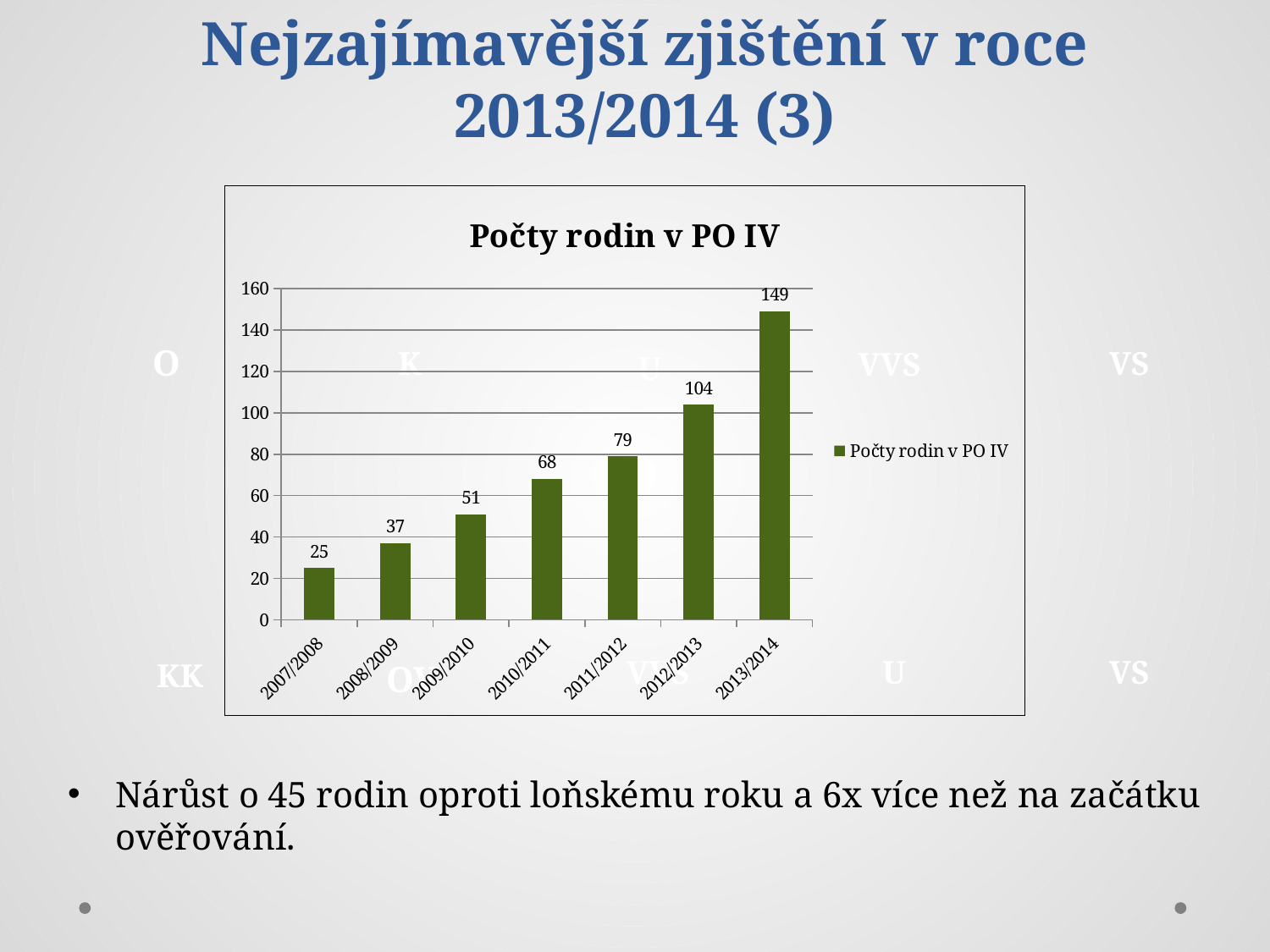
What is the difference between the values for 2013/2014 and 2012/2013? 45 What is the value for 2007/2008 in the chart? 25 Do the values rise or fall from 2007/2008 to 2013/2014? rise Which year has the lowest number of families in the chart? 2007/2008 What is the value for 2009/2010 in the chart? 51 Is the value for 2012/2013 greater or less than 100? greater What kind of chart is shown on the slide? bar chart Which year has the highest number of families in the chart? 2013/2014 How many years are shown on the x axis of the chart? 7 What is the difference between the values for 2011/2012 and 2010/2011? 11 Which is larger, the value for 2008/2009 or the value for 2010/2011? 2010/2011 What is the value for 2013/2014 in the chart? 149